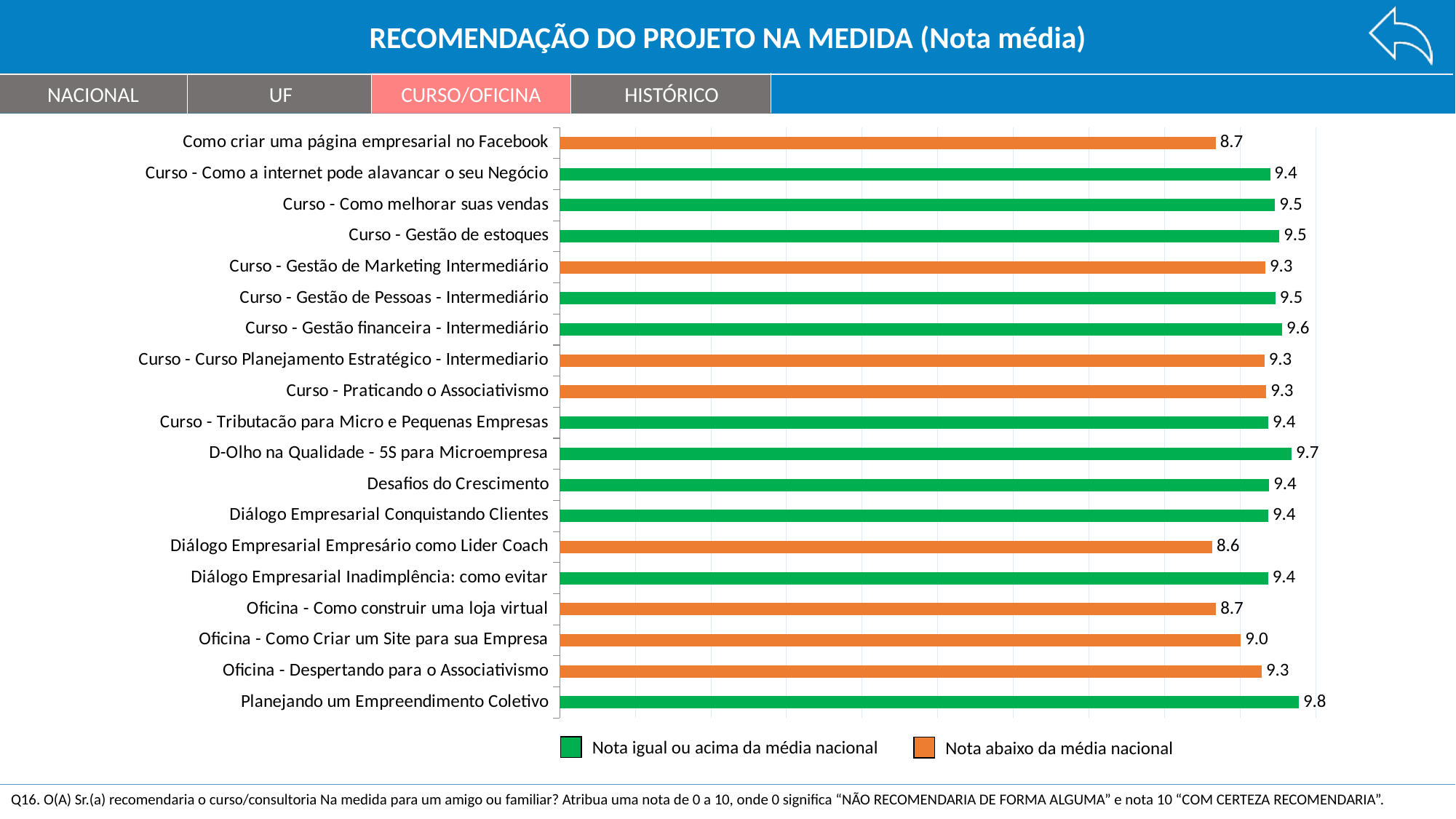
What is the title of the chart? RECOMENDAÇÃO DO PROJETO NA MEDIDA (Nota média) What is the average score for "Oficina - Como Criar um Site para sua Empresa"? 9.0 How many courses/workshops are shown in the chart? 19 Which course/workshop has the lowest average score? Diálogo Empresarial Empresário como Lider Coach What type of chart is shown on the slide? Bar chart Which has a higher score: "Curso - Como melhorar suas vendas" or "Curso - Gestão de Marketing Intermediário"? Curso - Como melhorar suas vendas What is the average score for "Curso - Gestão financeira - Intermediário"? 9.6 How many entries does the legend list? 2 What is the average score for "Planejando um Empreendimento Coletivo"? 9.8 Which course/workshop has the highest average score? Planejando um Empreendimento Coletivo What does the orange colour represent in the chart? Nota abaixo da média nacional What is the difference between the scores of "D-Olho na Qualidade - 5S para Microempresa" and "Como criar uma página empresarial no Facebook"? 1.0